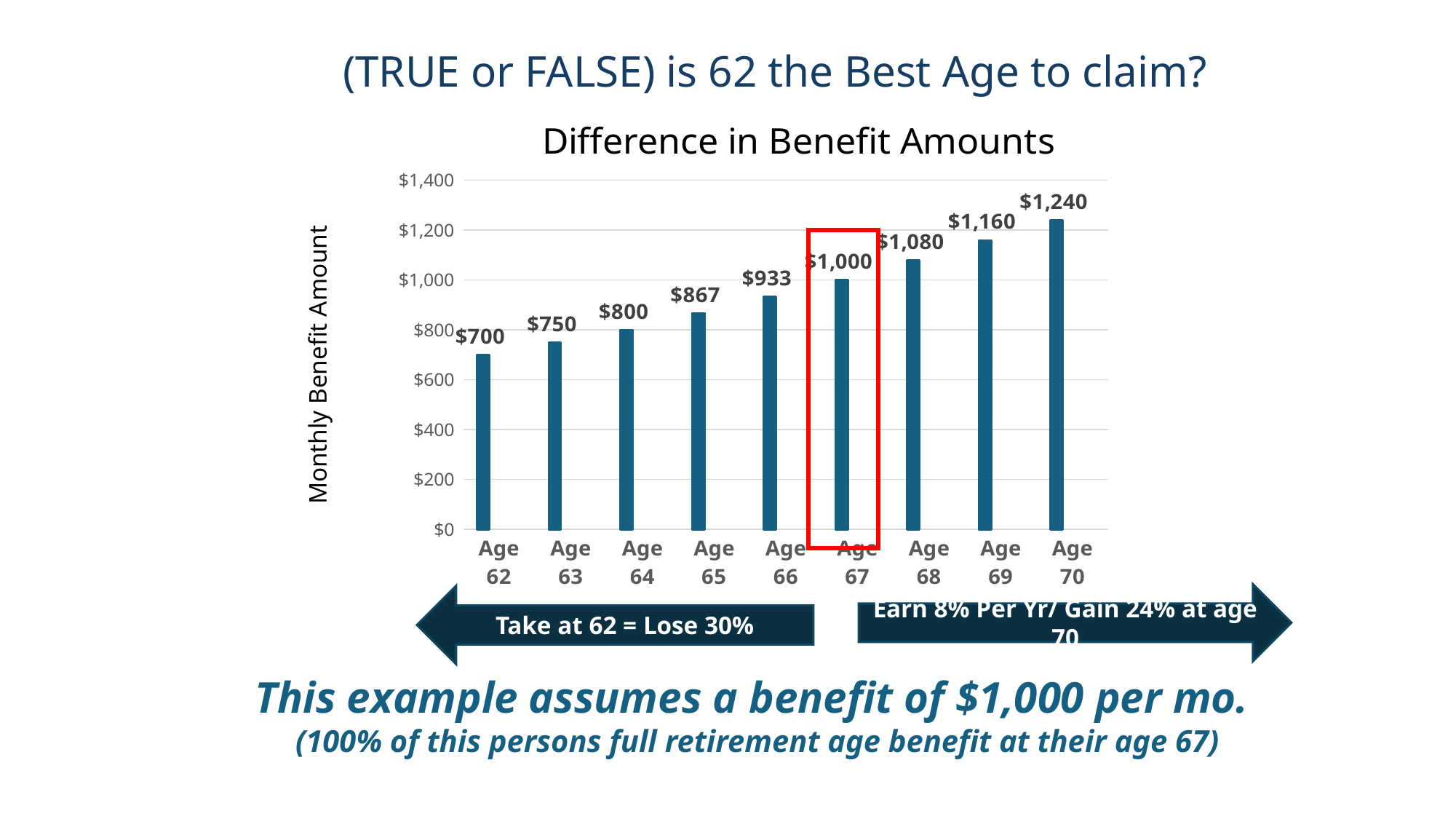
What is the title of the chart? Difference in Benefit Amounts How many age categories are shown on the x axis? 9 What is the monthly benefit amount for Age 67? $1,000 Which age has the lowest monthly benefit amount? Age 62 What is the difference in monthly benefit amount between Age 70 and Age 62? $540 What kind of chart is shown on the slide? Bar chart Which age has the highest monthly benefit amount? Age 70 Which is larger, the monthly benefit amount for Age 66 or for Age 64? Age 66 What is the monthly benefit amount for Age 65? $867 What is the monthly benefit amount for Age 62? $700 What is the difference in monthly benefit amount between Age 69 and Age 68? $80 Do the monthly benefit amounts rise or fall as age increases from 62 to 70? Rise